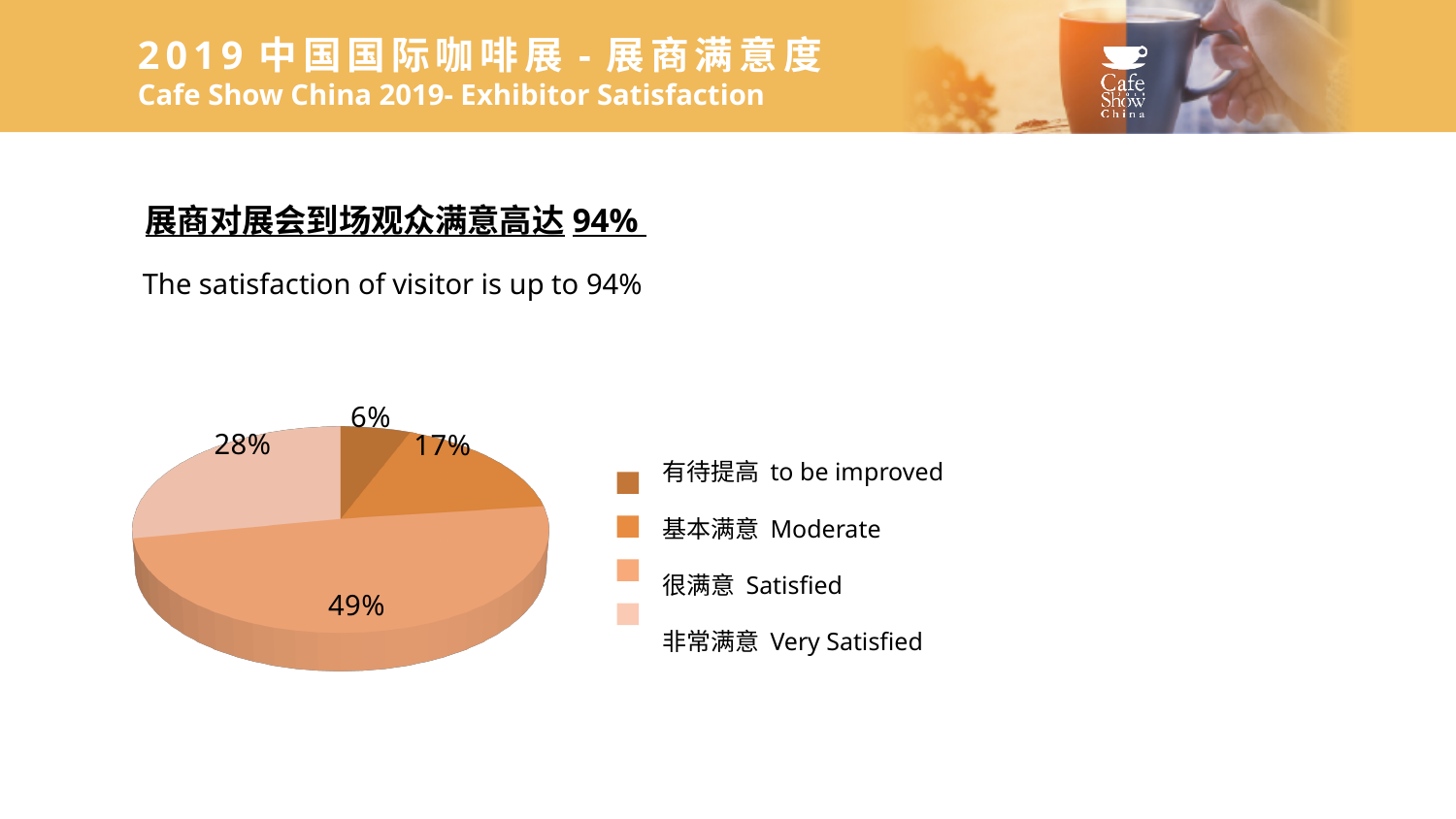
Which slice is larger, Moderate or Very Satisfied? Very Satisfied What is the difference in percentage points between the Satisfied and Very Satisfied slices? 21 What share of the pie is labelled Satisfied? 49% What share of the pie is labelled Moderate? 17% What is the combined share of the Satisfied and Very Satisfied slices? 77% How many slices does the pie chart have? 4 Which category has the largest slice of the pie? Satisfied What share of the pie is labelled 'to be improved'? 6% What share of the pie is labelled Very Satisfied? 28% Which category has the smallest slice of the pie? to be improved What type of chart is shown on the slide? pie chart How many entries does the legend list? 4